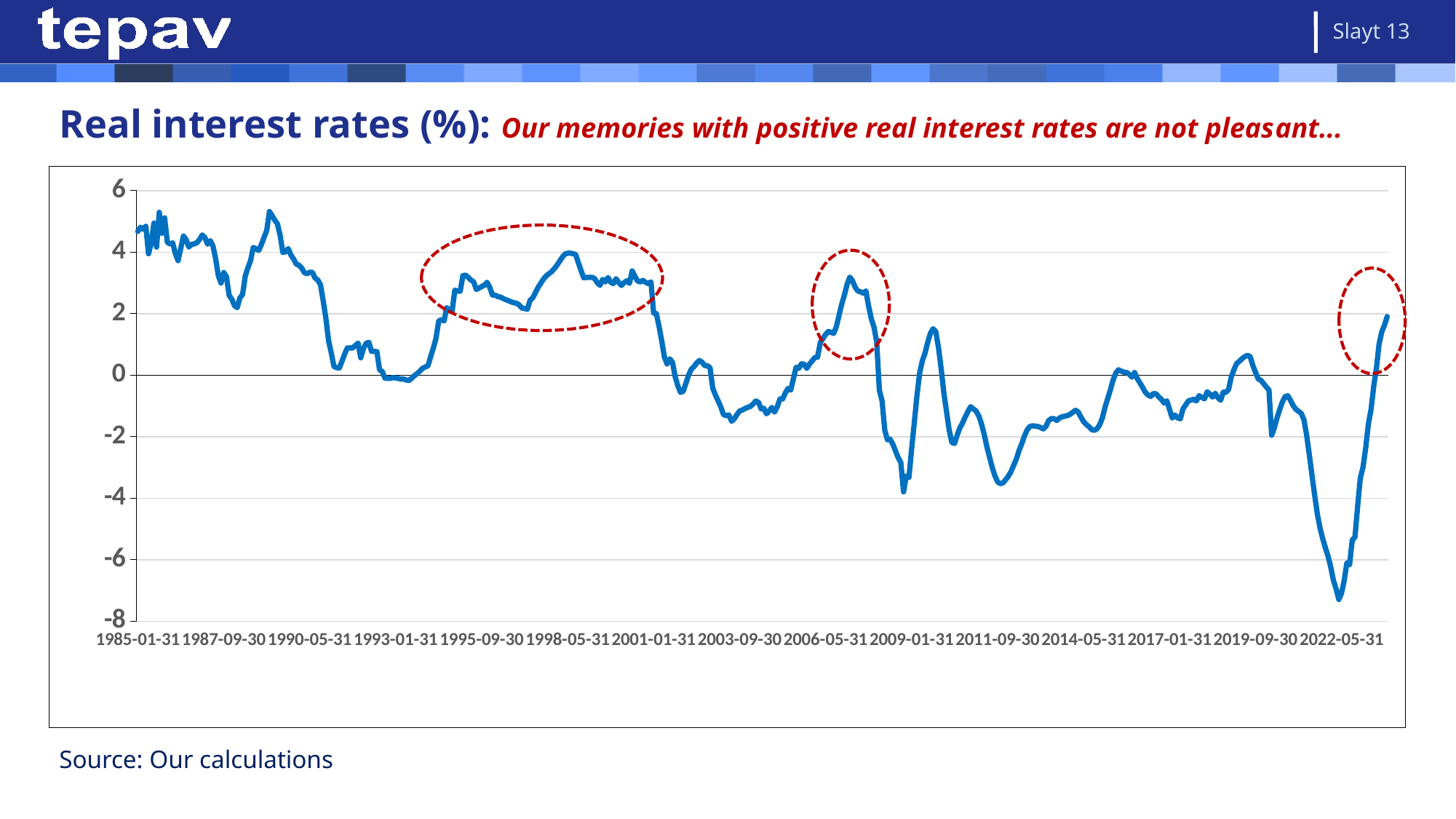
What is the title of the chart on the slide? Real interest rates (%) How many lines (series) are plotted on the chart? 1 How many date labels are shown on the x axis? 15 Is the value at 2011-09-30 greater or less than -2? less What kind of chart is shown on the slide? line chart Is the value at 1985-01-31 greater or less than 4? greater How many red dashed ellipses are drawn on the chart? 3 Is the lowest point of the line greater or less than -6? less Does the line rise or fall overall from 1985-01-31 to the end of the series? fall Around which x-axis label does the line reach its lowest value? 2022-05-31